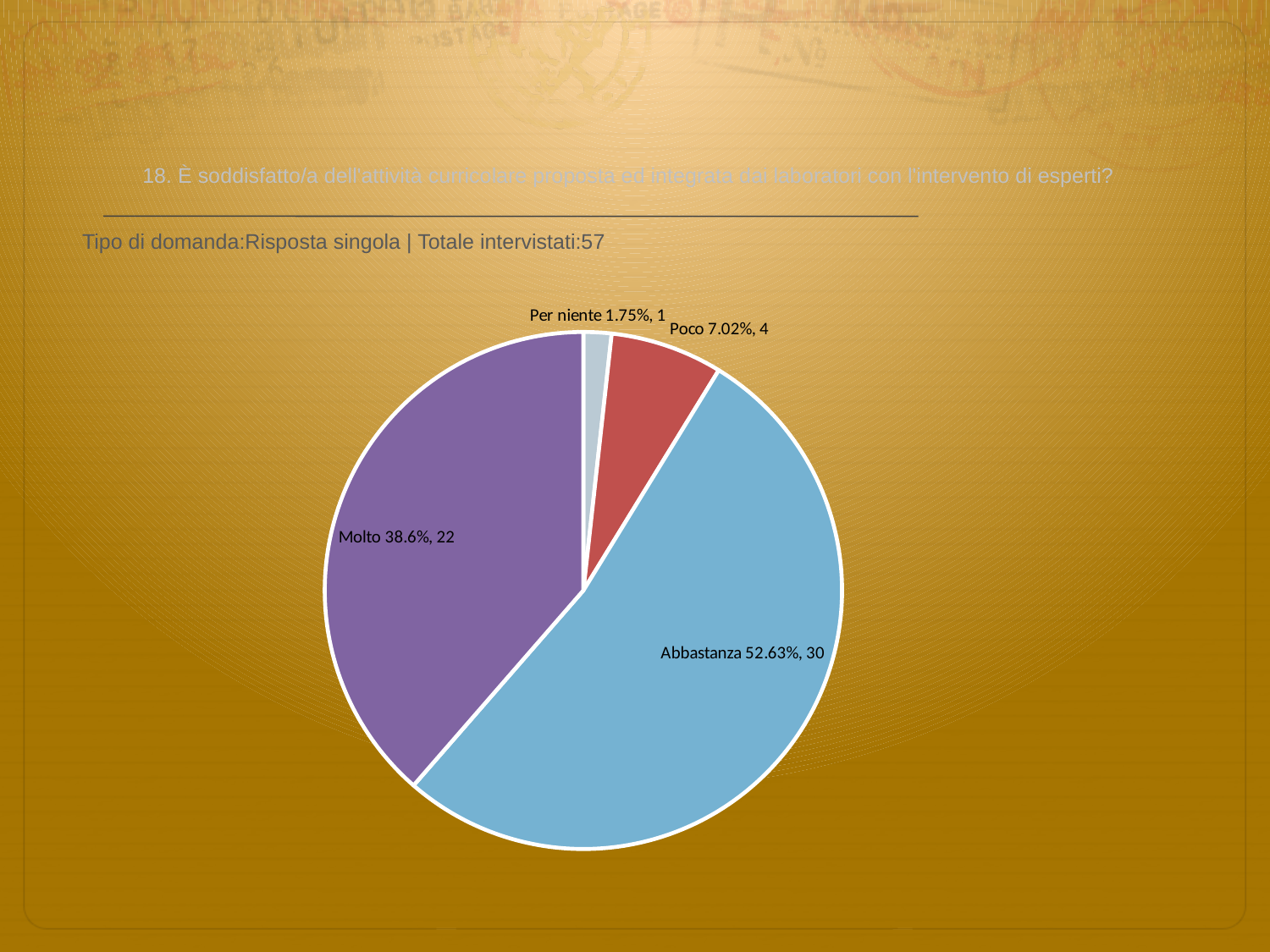
What percentage share does the Abbastanza slice have? 52.63% What is the total number of respondents across all slices? 57 Which category has the smallest slice? Per niente What is the difference in respondent count between Abbastanza and Molto? 8 Which has more respondents, Poco or Per niente? Poco How many respondents answered Poco? 4 What kind of chart is shown on the slide? pie chart Which category has the largest slice? Abbastanza How many slices does the pie chart have? 4 What colour is the Molto slice? purple How many respondents answered Molto? 22 What percentage share does the Per niente slice have? 1.75%